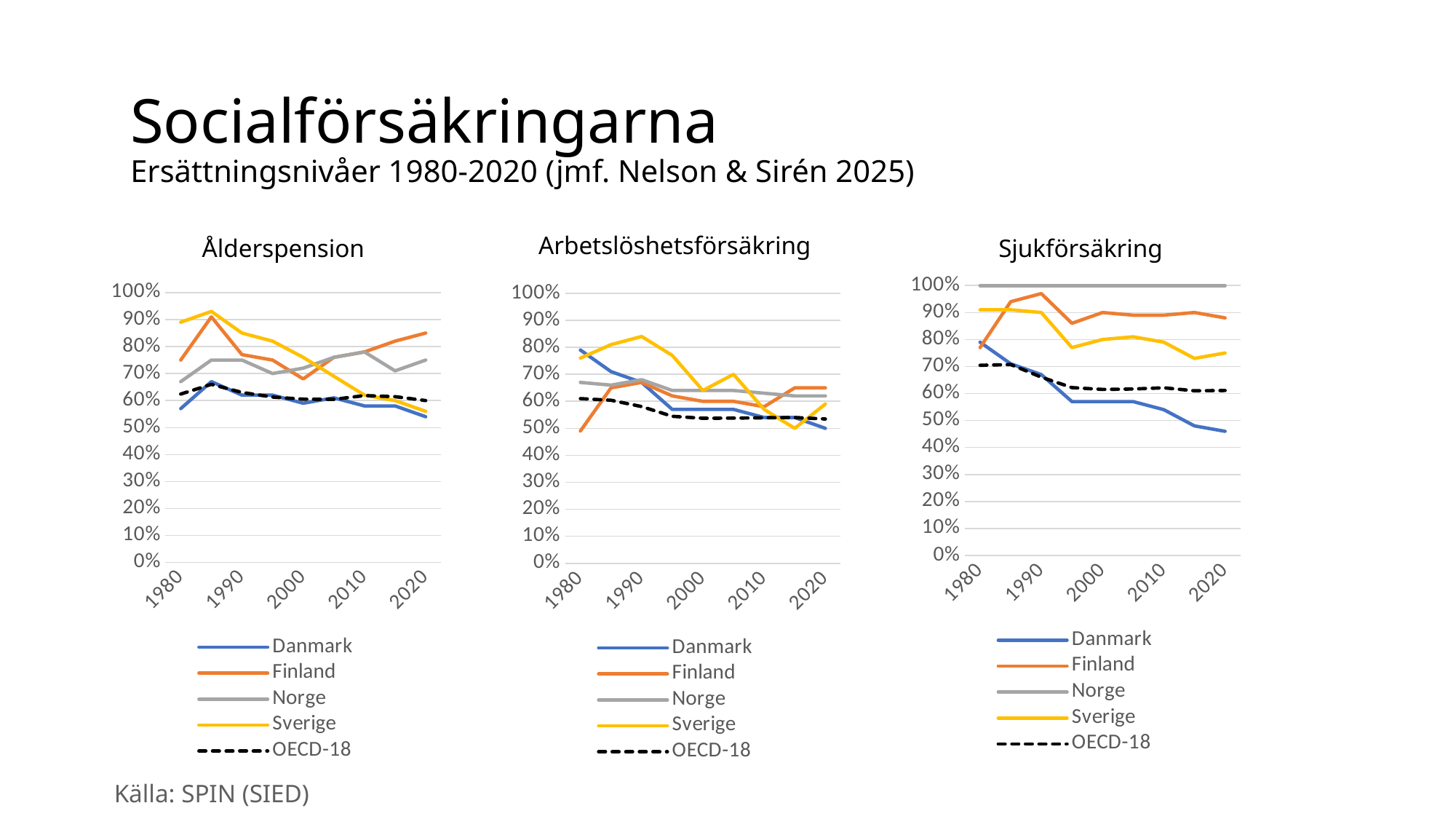
In the Arbetslöshetsförsäkring chart, does the value for Danmark rise or fall from 1980 to 2020? fall In the Ålderspension chart, which series has the highest value in 2020? Finland In the Sjukförsäkring chart, which series is highest across the whole period? Norge In the Sjukförsäkring chart, is the value for Finland in 2020 greater or less than 80%? greater In the Ålderspension chart, does the value for Sverige rise or fall from 1980 to 2020? fall In the Arbetslöshetsförsäkring chart, is the value for Danmark in 1980 greater or less than 70%? greater What kind of chart is the Ålderspension chart? line chart In the Sjukförsäkring chart, what is the value for Norge in 2020? 100% In the Ålderspension chart, which series has the lowest value in 2020? Danmark Which series is drawn as a dashed black line in all three charts? OECD-18 In the Sjukförsäkring chart, is the value for Danmark in 2020 greater or less than 50%? less How many series does the legend of the Sjukförsäkring chart list? 5